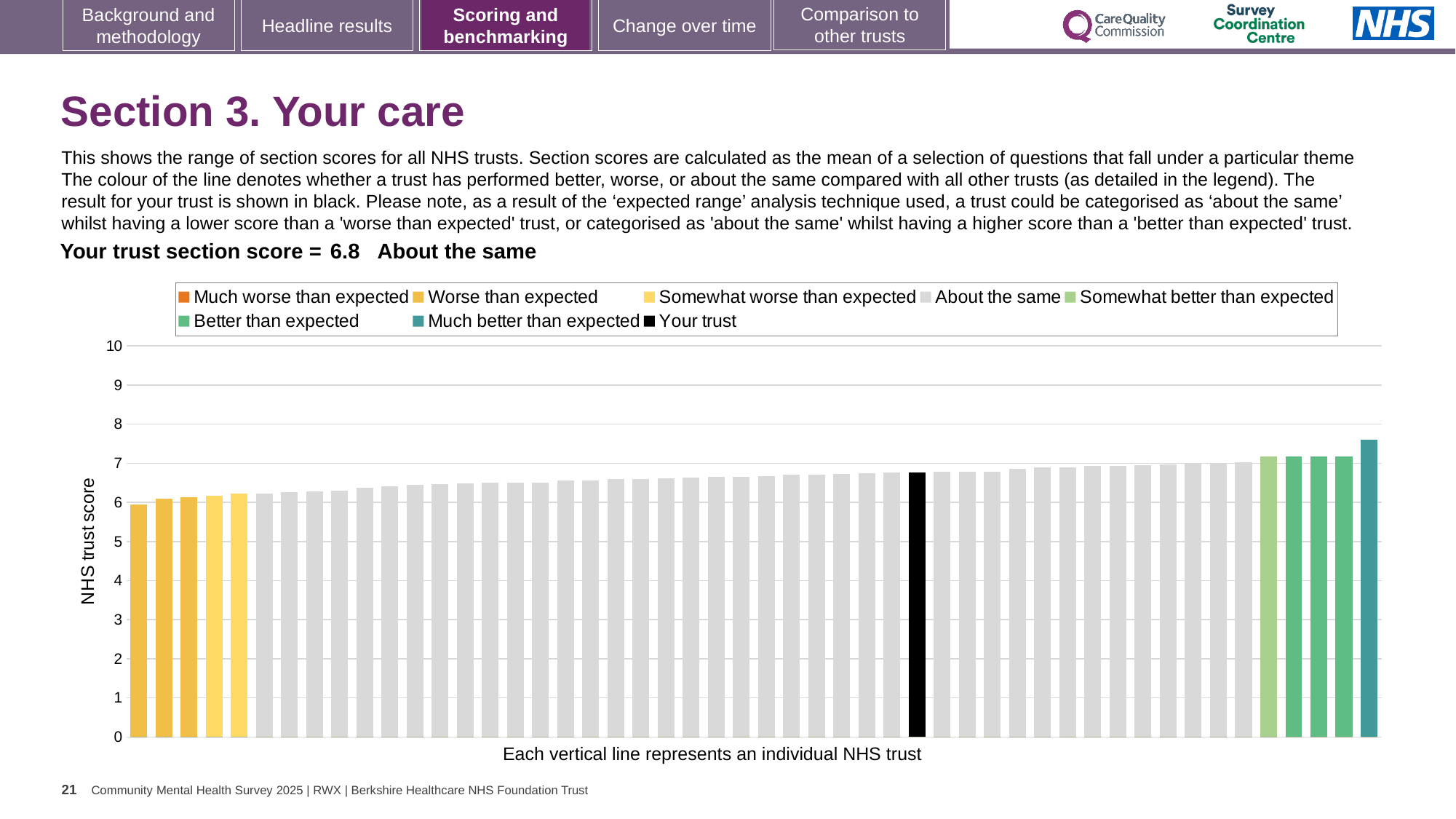
Do the bar values rise or fall from left to right across the chart? rise Which legend category does the tallest bar belong to? Much better than expected What kind of chart is shown on the slide? bar chart What is the section score for your trust shown on the slide? 6.8 How many entries does the chart legend list? 8 Is the value of the shortest bar greater or less than 7? less Which legend category does the shortest bar belong to? Worse than expected What is the title of the vertical axis? NHS trust score Which is larger: the value for your trust (black bar) or the value of the leftmost bar? Your trust Which category is your trust placed in for this section? About the same Is the value for your trust (the black bar) greater or less than 6? greater Is the value of the tallest bar greater or less than 7? greater